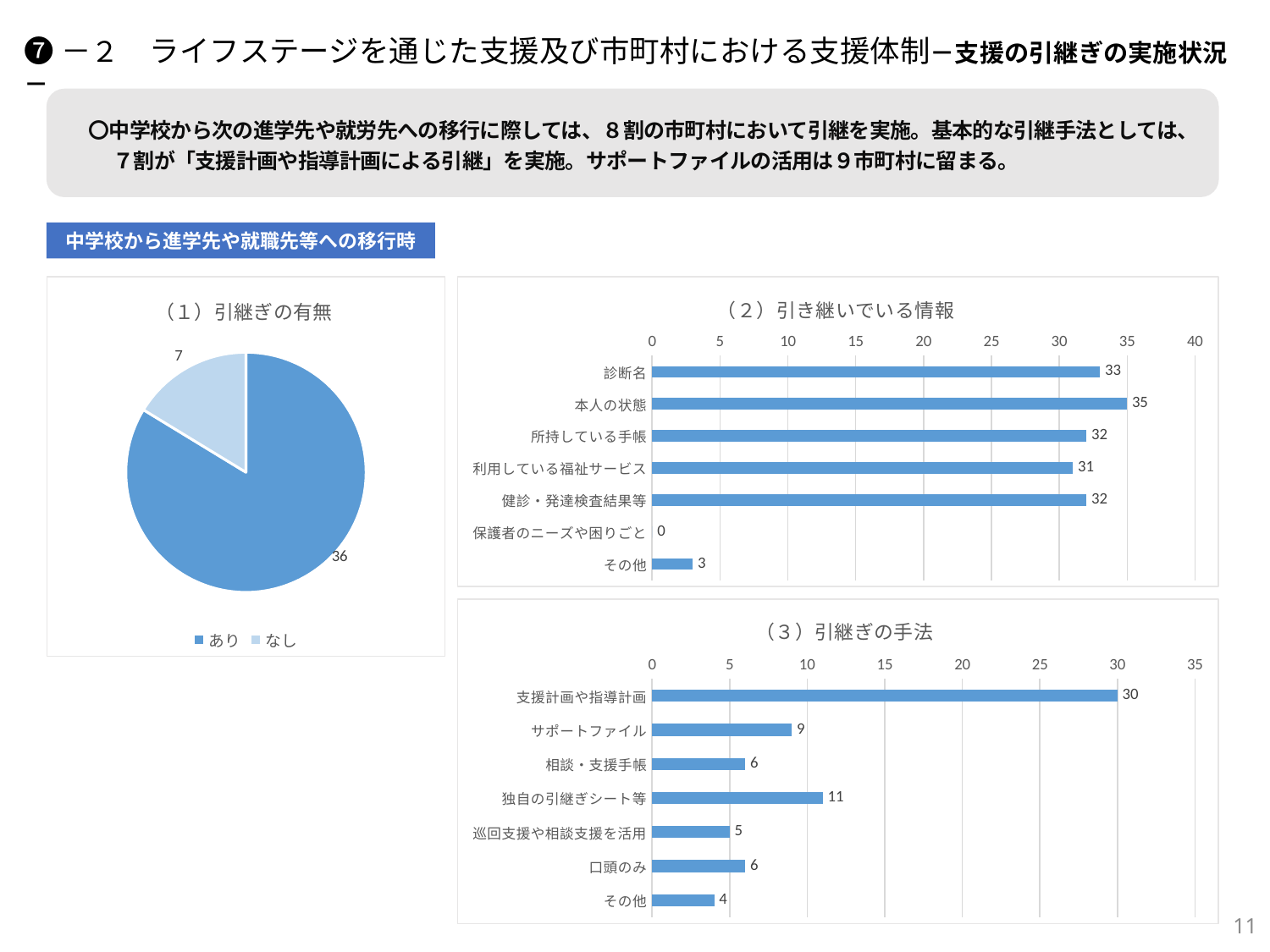
In the chart titled （2）引き継いでいる情報, how many categories are shown? 7 In the chart titled （2）引き継いでいる情報, which category has the highest value? 本人の状態 In the chart titled （1）引継ぎの有無, what is the value for あり? 36 In the chart titled （3）引継ぎの手法, which category has the highest value? 支援計画や指導計画 In the chart titled （3）引継ぎの手法, which is larger, 独自の引継ぎシート等 or 巡回支援や相談支援を活用? 独自の引継ぎシート等 In the chart titled （3）引継ぎの手法, what is the value for サポートファイル? 9 In the chart titled （2）引き継いでいる情報, which category has the lowest value? 保護者のニーズや困りごと In the chart titled （2）引き継いでいる情報, what is the difference between 診断名 and その他? 30 In the chart titled （1）引継ぎの有無, how many entries does the legend list? 2 In the chart titled （2）引き継いでいる情報, what is the value for 本人の状態? 35 In the chart titled （3）引継ぎの手法, what kind of chart is shown? bar chart In the chart titled （1）引継ぎの有無, what kind of chart is shown? pie chart